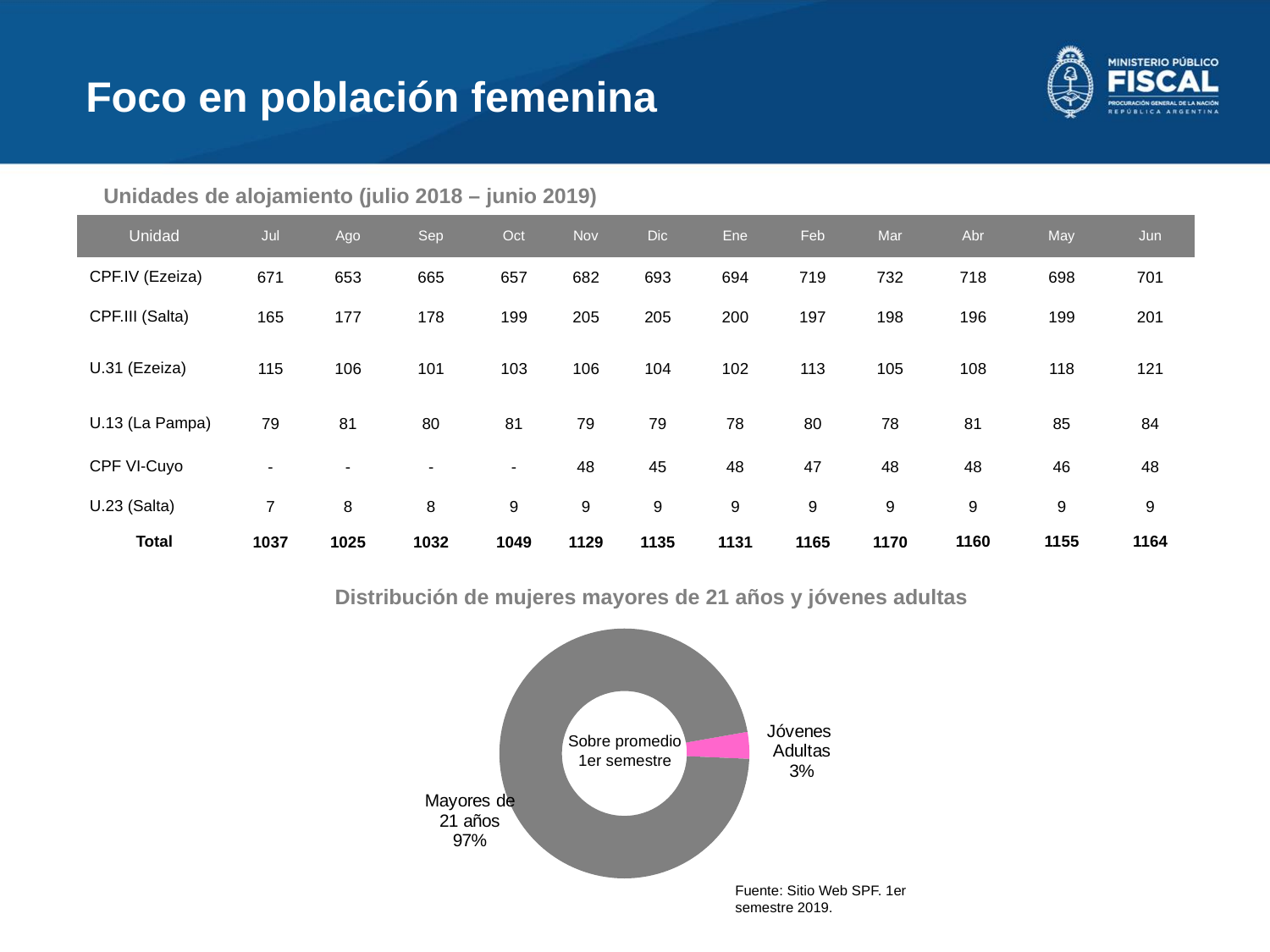
What share of the doughnut chart is labelled "Mayores de 21 años"? 97% In the doughnut chart, which is larger: the share for Mayores de 21 años or the share for Jóvenes Adultas? Mayores de 21 años What is the title of the chart at the bottom of the slide? Distribución de mujeres mayores de 21 años y jóvenes adultas Which category has the smallest share in the doughnut chart? Jóvenes Adultas By how many percentage points does the share of Mayores de 21 años exceed the share of Jóvenes Adultas in the doughnut chart? 94 percentage points Which category has the largest share in the doughnut chart? Mayores de 21 años What share of the doughnut chart is labelled "Jóvenes Adultas"? 3% How many categories are shown in the doughnut chart? 2 What type of chart is shown at the bottom of the slide? Doughnut chart What colour is the Jóvenes Adultas slice in the doughnut chart? Pink